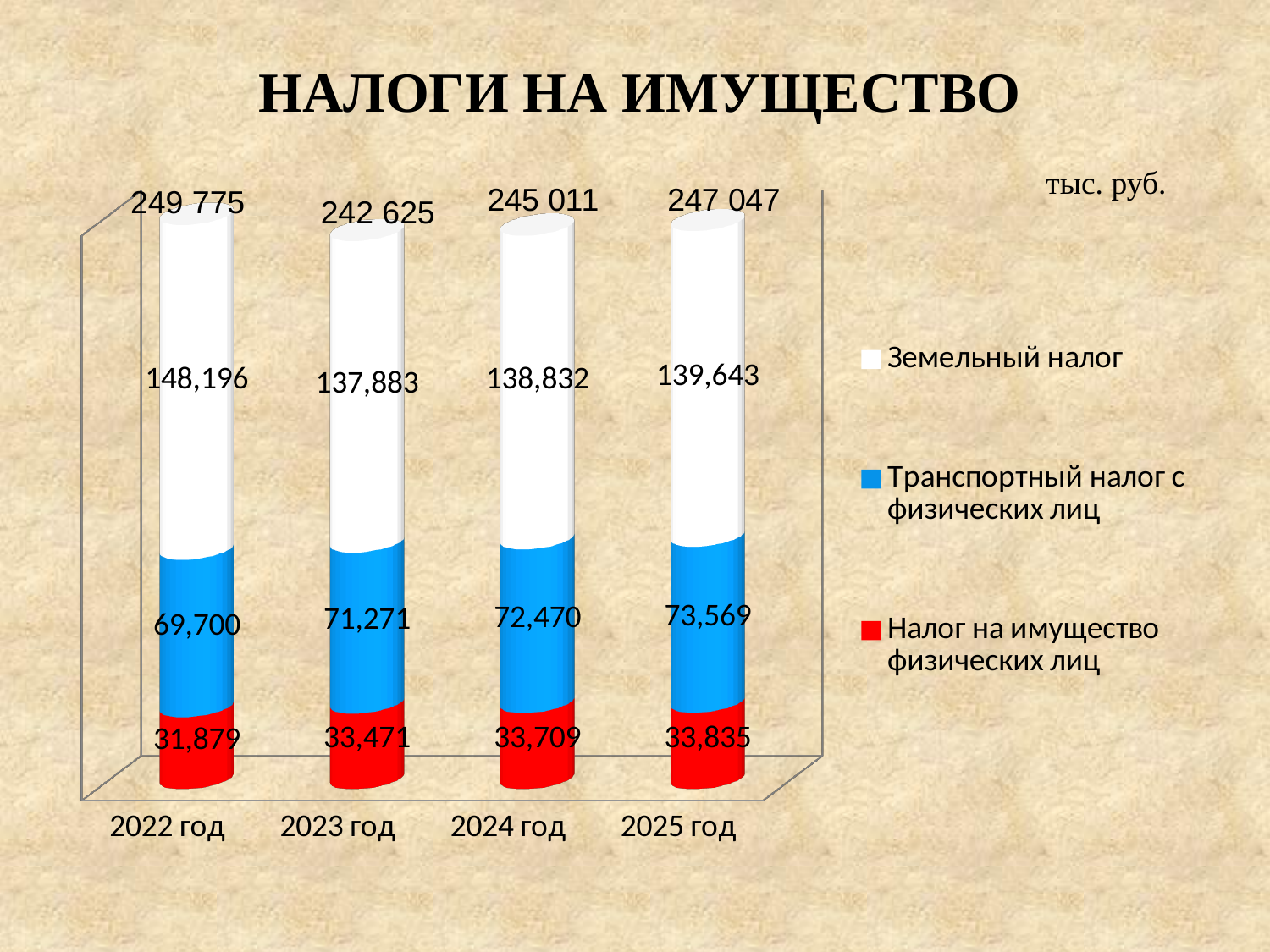
How many years are shown on the x axis? 4 Which year has the lowest value for Налог на имущество физических лиц? 2022 год What is the value of Налог на имущество физических лиц for 2023 год? 33,471 Which year has the highest value for Земельный налог? 2022 год How many series does the legend list? 3 What is the value of Транспортный налог с физических лиц for 2025 год? 73,569 What is the value of Земельный налог for 2022 год? 148,196 Do the values for Транспортный налог с физических лиц rise or fall from 2022 год to 2025 год? Rise What is the total of the stacked bar for 2024 год? 245 011 Which is larger: Земельный налог for 2023 год or for 2024 год? 2024 год What kind of chart is shown on the slide? Stacked bar chart What is the difference between the Транспортный налог с физических лиц values for 2025 год and 2022 год? 3,869